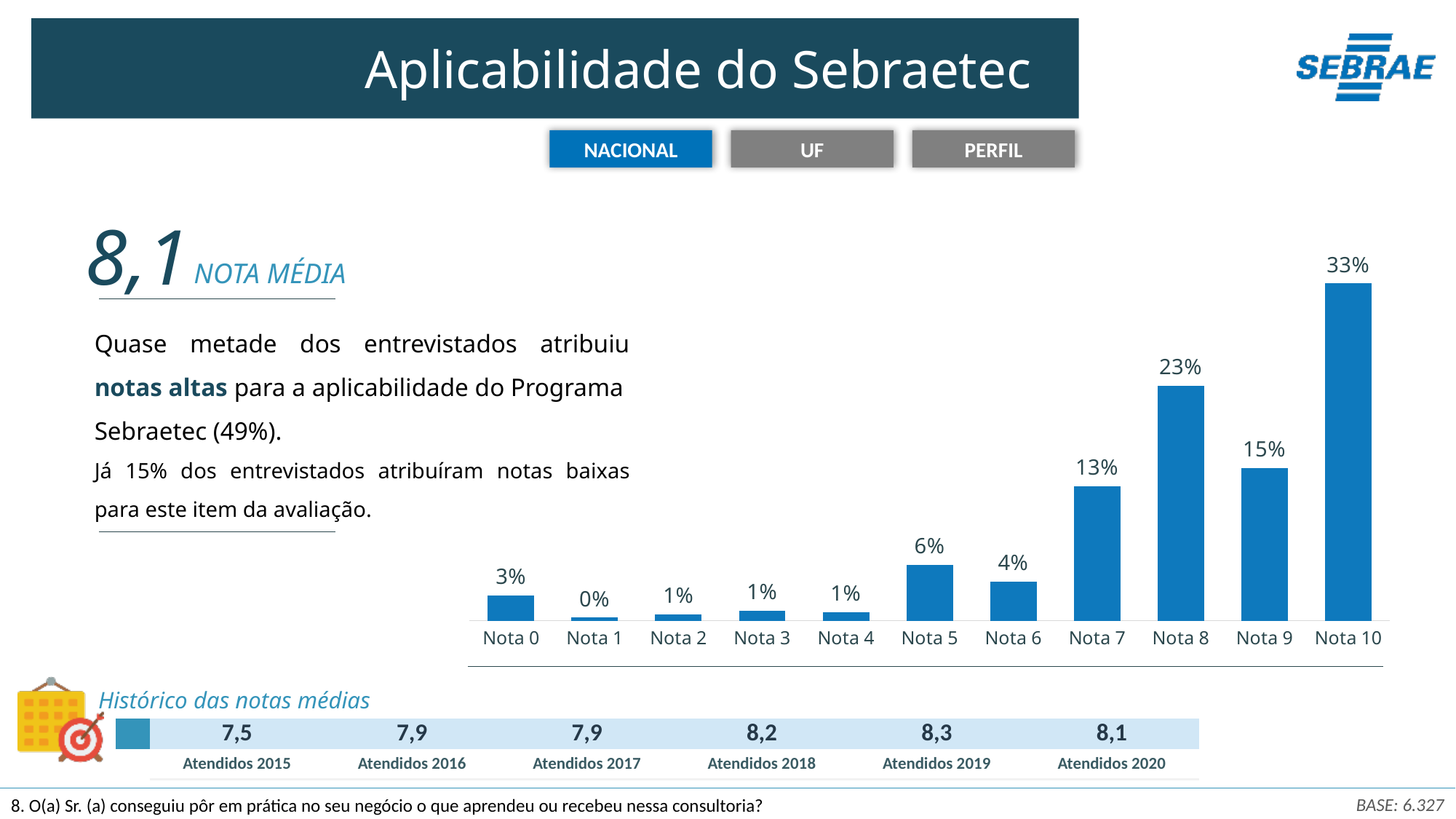
Which category has the lowest value? Nota 1 What is the title of the slide containing the chart? Aplicabilidade do Sebraetec Which is larger, the value for Nota 5 or the value for Nota 6? Nota 5 What kind of chart is shown on the slide? Bar chart What is the value for Nota 10? 33% What is the value for Nota 0? 3% What is the difference between the values for Nota 10 and Nota 8? 10% What is the combined value of Nota 8, Nota 9 and Nota 10? 71% Do the values generally rise or fall from Nota 5 to Nota 10? Rise What is the value for Nota 7? 13% Which category has the highest value? Nota 10 How many categories are shown on the x axis of the bar chart? 11